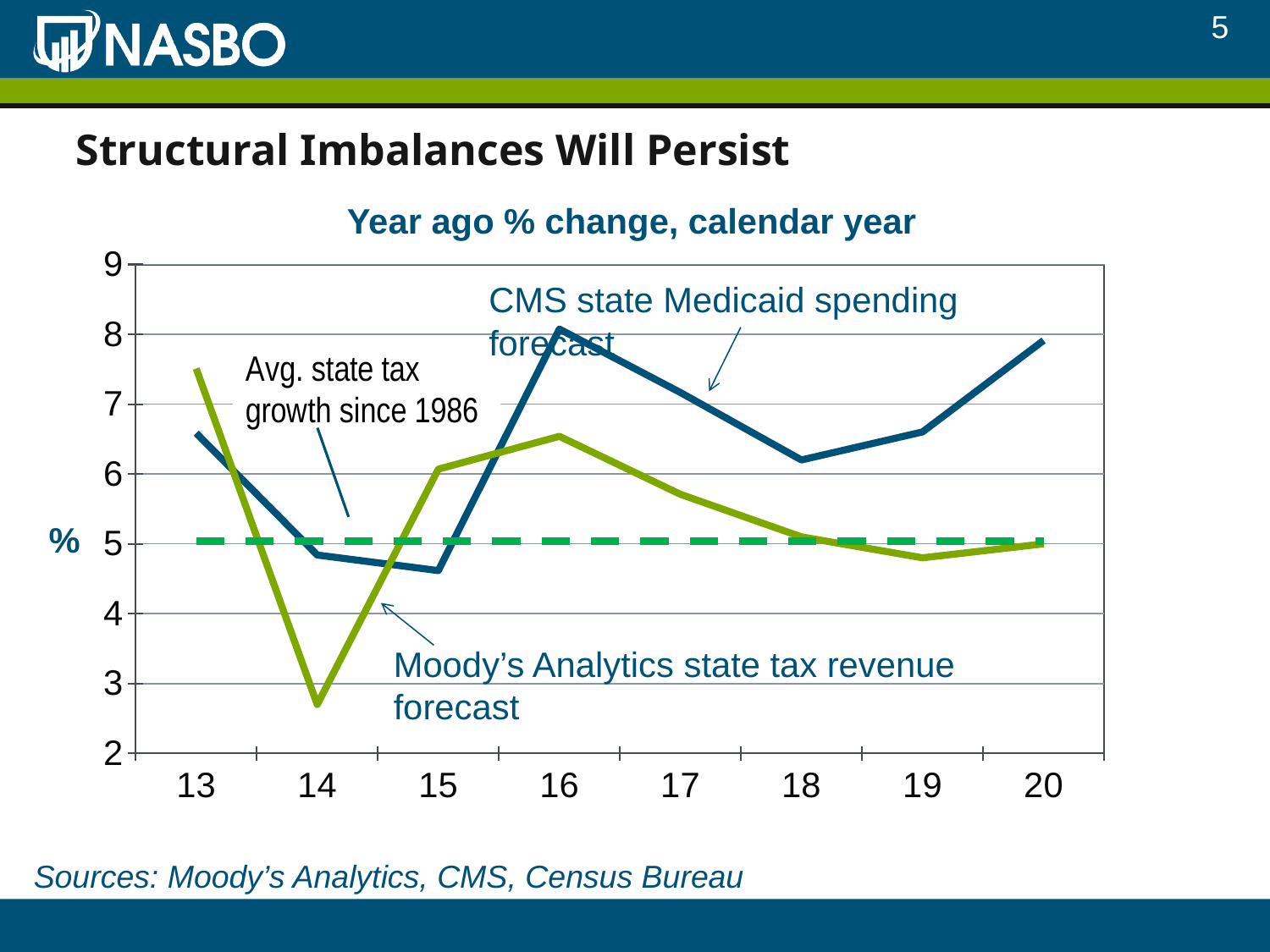
Is the CMS state Medicaid spending forecast value for 15 greater or less than 5? less What is the title printed above the chart? Year ago % change, calendar year What kind of chart is shown on the slide? line chart Is the Moody's Analytics state tax revenue forecast value for 14 greater or less than 3? less In which year does the Moody's Analytics state tax revenue forecast line reach its lowest point? 14 Does the CMS state Medicaid spending forecast line rise or fall from 16 to 18? fall How many years are marked along the x axis of the chart? 8 In which year does the Moody's Analytics state tax revenue forecast line reach its highest point? 13 Is the CMS state Medicaid spending forecast value for 16 greater or less than 7? greater At 17, which line is higher: the CMS state Medicaid spending forecast or the Moody's Analytics state tax revenue forecast? CMS state Medicaid spending forecast How many lines are plotted on the chart? 3